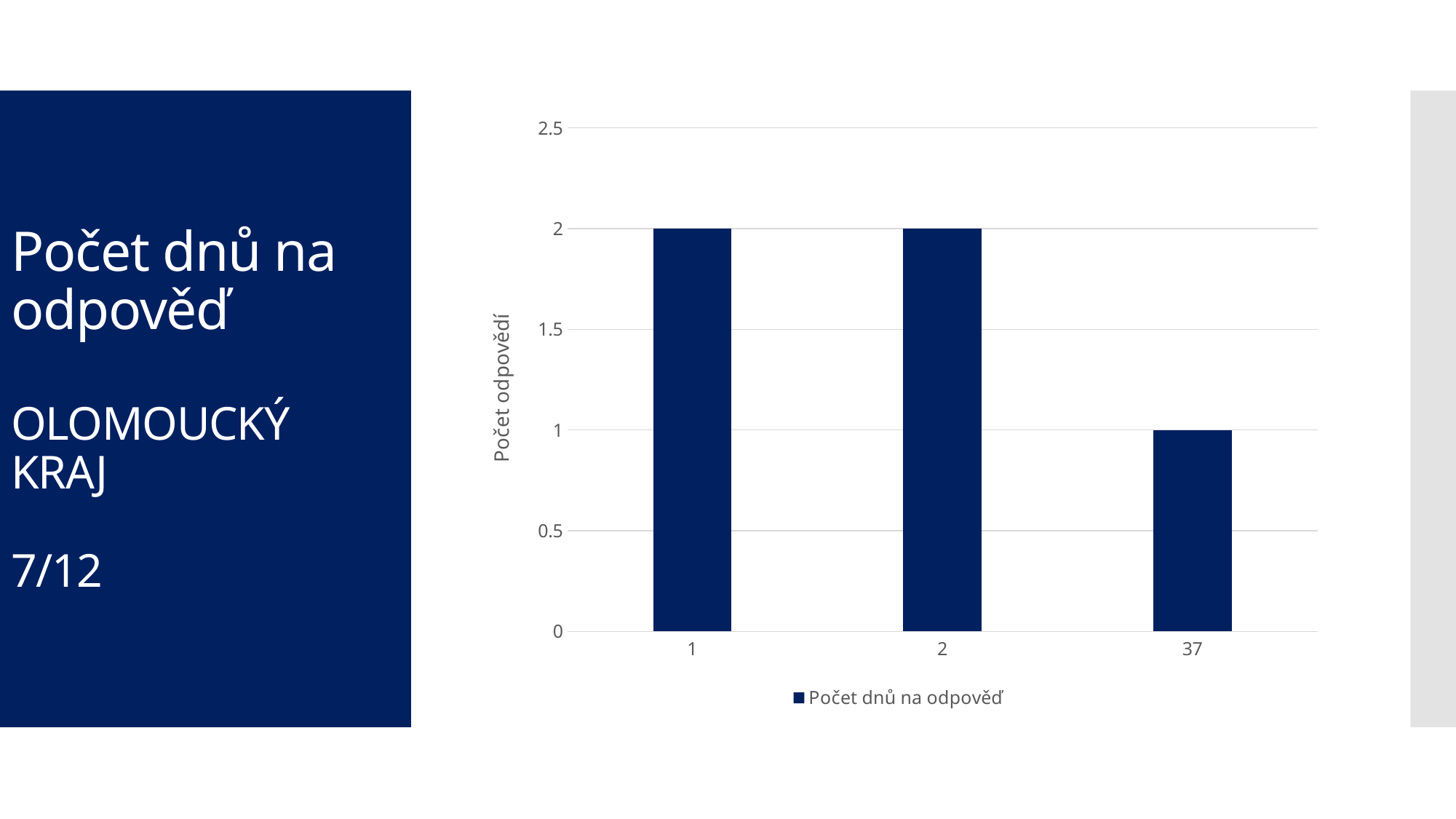
What is the value for category 1 in the chart? 2 How many bars (categories) are shown on the x axis of the chart? 3 What type of chart is shown on the slide? bar chart What is the difference between the value for category 2 and the value for category 37? 1 What series name is shown in the chart legend? Počet dnů na odpověď What is the label of the y axis of the chart? Počet odpovědí What is the value for category 37 in the chart? 1 Is the value for category 37 greater or less than 1.5? less How many series does the chart legend list? 1 Which category has the lowest value in the chart? 37 Which is larger, the value for category 1 or the value for category 37? 1 What is the value for category 2 in the chart? 2